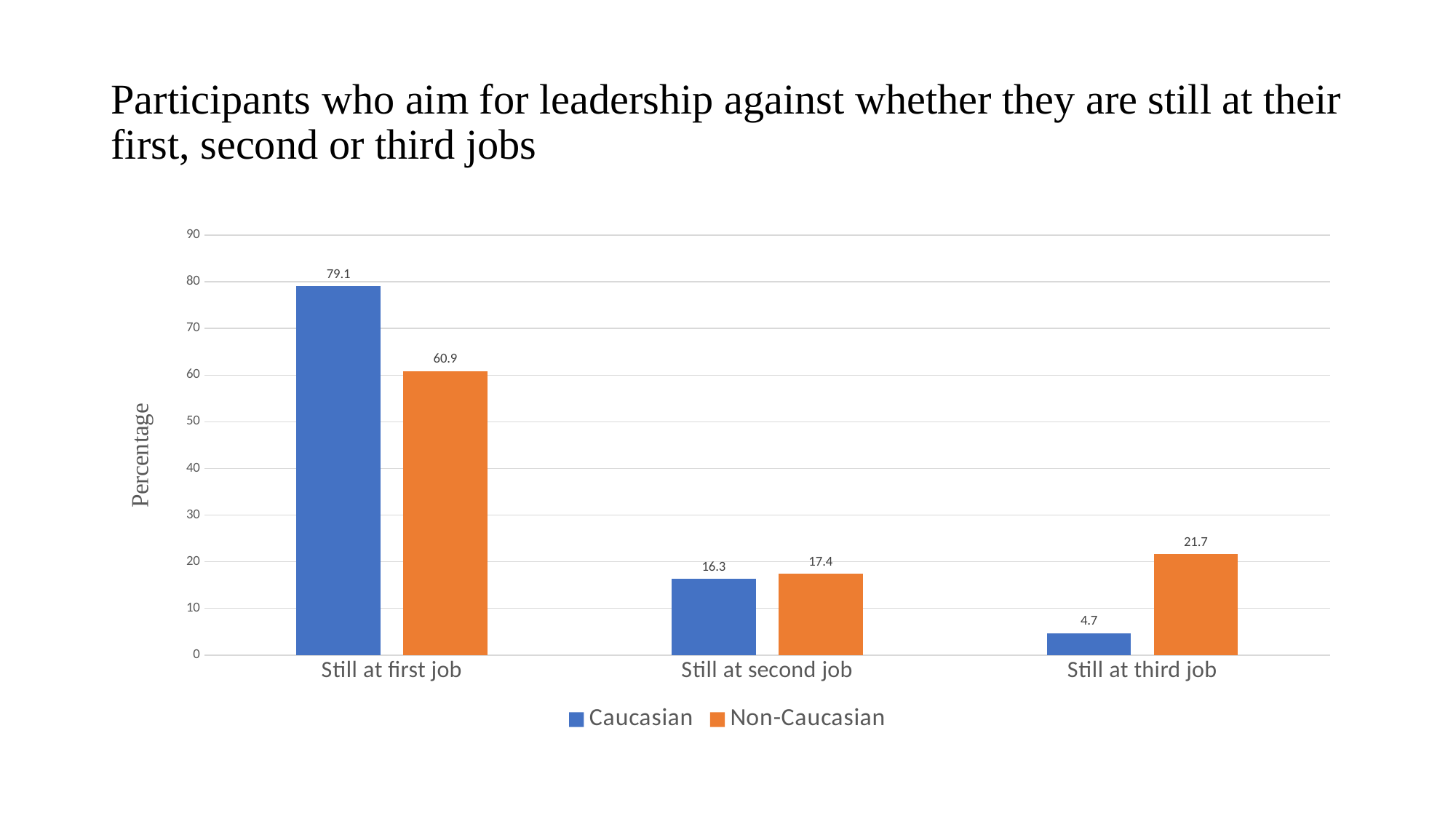
What is the value for Non-Caucasian participants who are still at their second job? 17.4 What is the difference between the Non-Caucasian and Caucasian values for 'Still at third job'? 17 How many job categories are shown on the x axis? 3 What kind of chart is shown on the slide? Bar chart What is the value for Caucasian participants who are still at their first job? 79.1 What is the label of the y axis? Percentage Which category has the lowest value for the Caucasian series? Still at third job How many series does the legend list? 2 For 'Still at third job', which series has the larger value, Caucasian or Non-Caucasian? Non-Caucasian What is the value for Non-Caucasian participants who are still at their third job? 21.7 Which category has the highest value for the Non-Caucasian series? Still at first job What is the difference between the Caucasian and Non-Caucasian values for 'Still at first job'? 18.2